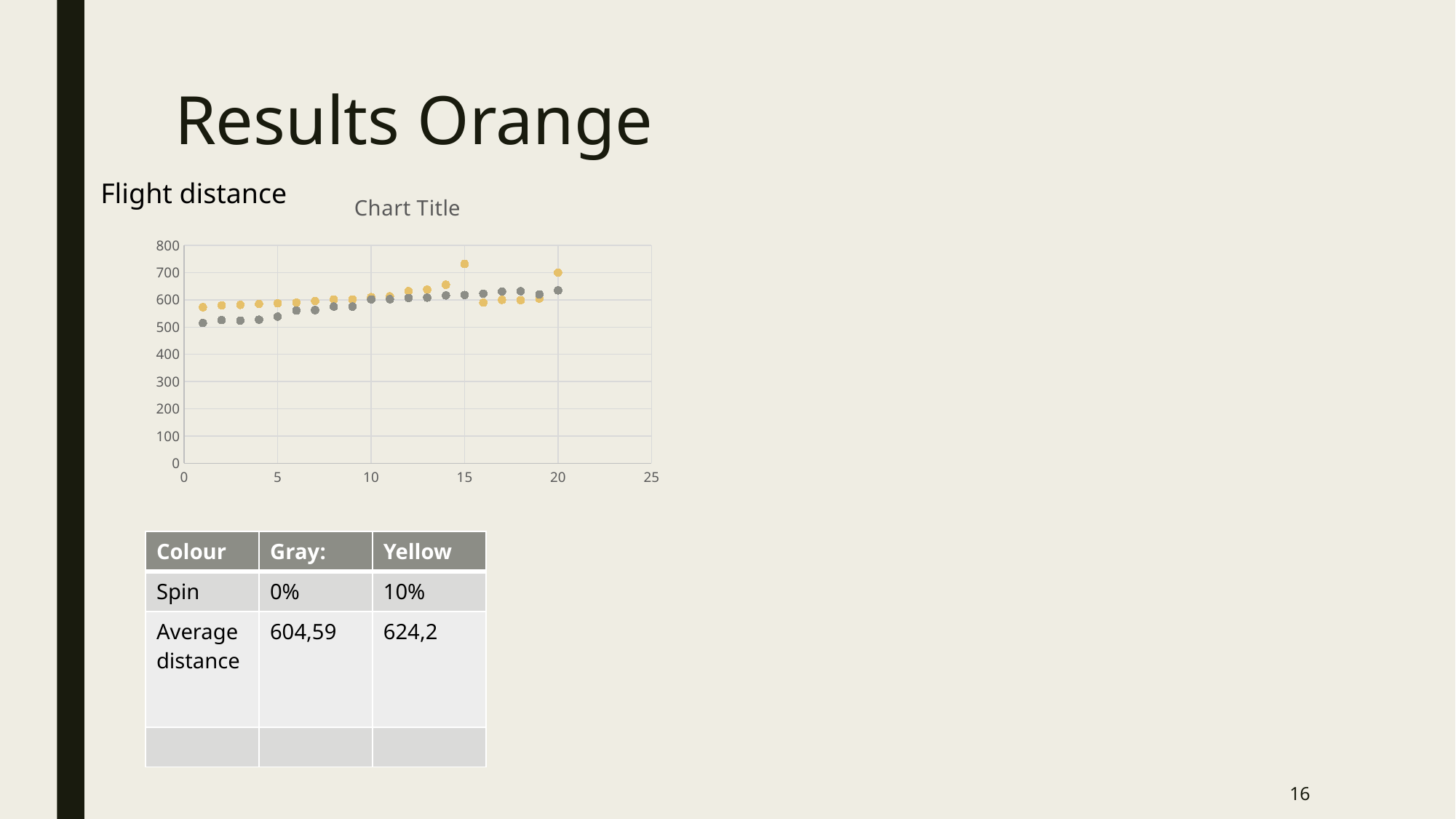
Is the value of the yellow point at x = 1 greater or less than 500? greater What is the title shown above the chart? Chart Title At which x value does the yellow series reach its highest point? 15 Is the value of the yellow point at x = 15 greater or less than 700? greater At which x value does the gray series have its lowest point? 1 What kind of chart is shown on the slide? scatter chart At x = 1, which point is higher, the gray one or the yellow one? yellow Is the value of the gray point at x = 20 greater or less than 600? greater How many gray points are plotted in the chart? 20 Do the gray points rise or fall as the x value increases from 1 to 20? rise What two colours are used for the plotted points in the chart? gray and yellow